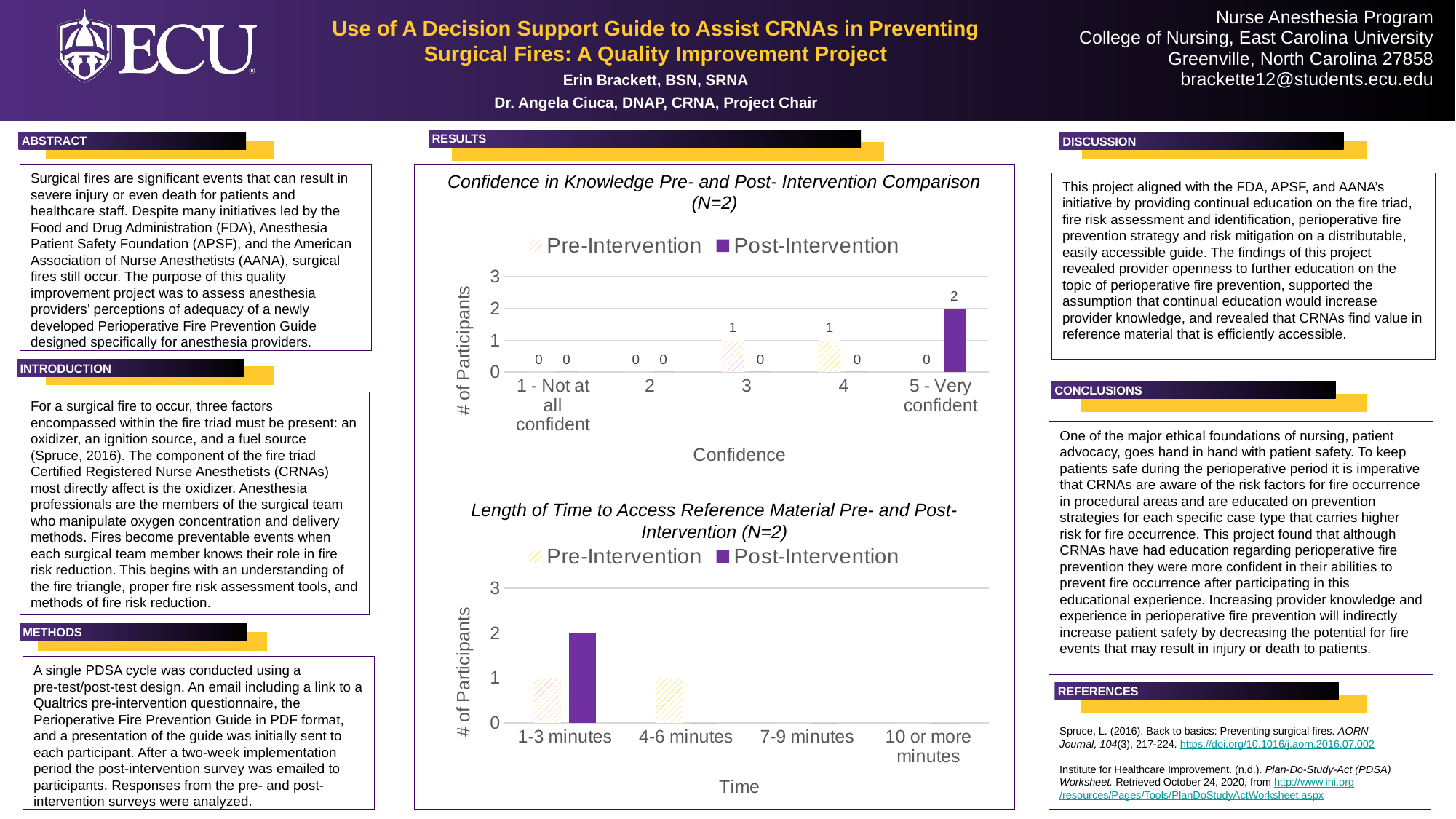
In the Confidence in Knowledge chart, what is the pre-intervention value for confidence level 3? 1 In the Confidence in Knowledge chart, what is the pre-intervention value for 5 - Very confident? 0 In the Length of Time to Access Reference Material chart, which time category has the highest post-intervention value? 1-3 minutes In the Confidence in Knowledge chart, which confidence level has the highest post-intervention value? 5 - Very confident In the Length of Time to Access Reference Material chart, how many participants reported 4-6 minutes pre-intervention? 1 In the Length of Time to Access Reference Material chart, how many participants reported 1-3 minutes post-intervention? 2 In the Confidence in Knowledge chart, how many participants rated their confidence as 5 - Very confident post-intervention? 2 How many series does the legend of the Confidence in Knowledge chart list? 2 What kind of chart is the Length of Time to Access Reference Material chart? Bar chart In the Confidence in Knowledge chart, how many confidence categories are shown on the x axis? 5 What is the x-axis title of the Length of Time to Access Reference Material chart? Time In the Confidence in Knowledge chart, what is the difference between the post-intervention and pre-intervention values for 5 - Very confident? 2